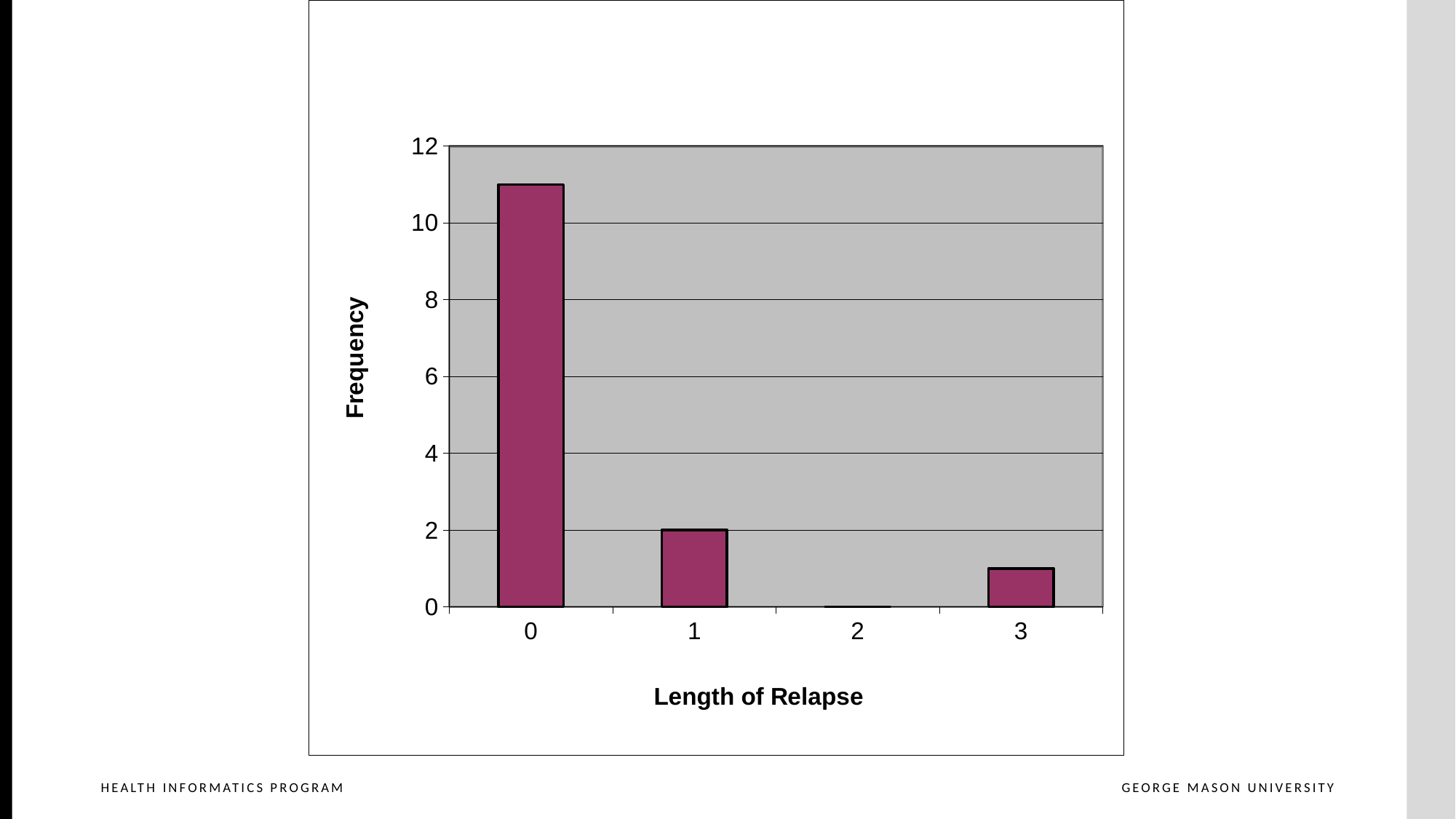
What is the difference in frequency between a length of relapse of 1 and a length of relapse of 2? 2 Is the frequency for a length of relapse of 0 greater or less than 10? greater What is the frequency for a length of relapse of 2? 0 What is the frequency for a length of relapse of 1? 2 What kind of chart is shown on the slide? bar chart Which has a higher frequency: a length of relapse of 1 or of 3? 1 What is the title of the y axis of the chart? Frequency Is the frequency for a length of relapse of 3 greater or less than 2? less Which length of relapse has the lowest frequency? 2 What is the title of the x axis of the chart? Length of Relapse How many categories are shown on the x axis of the chart? 4 Which length of relapse has the highest frequency? 0